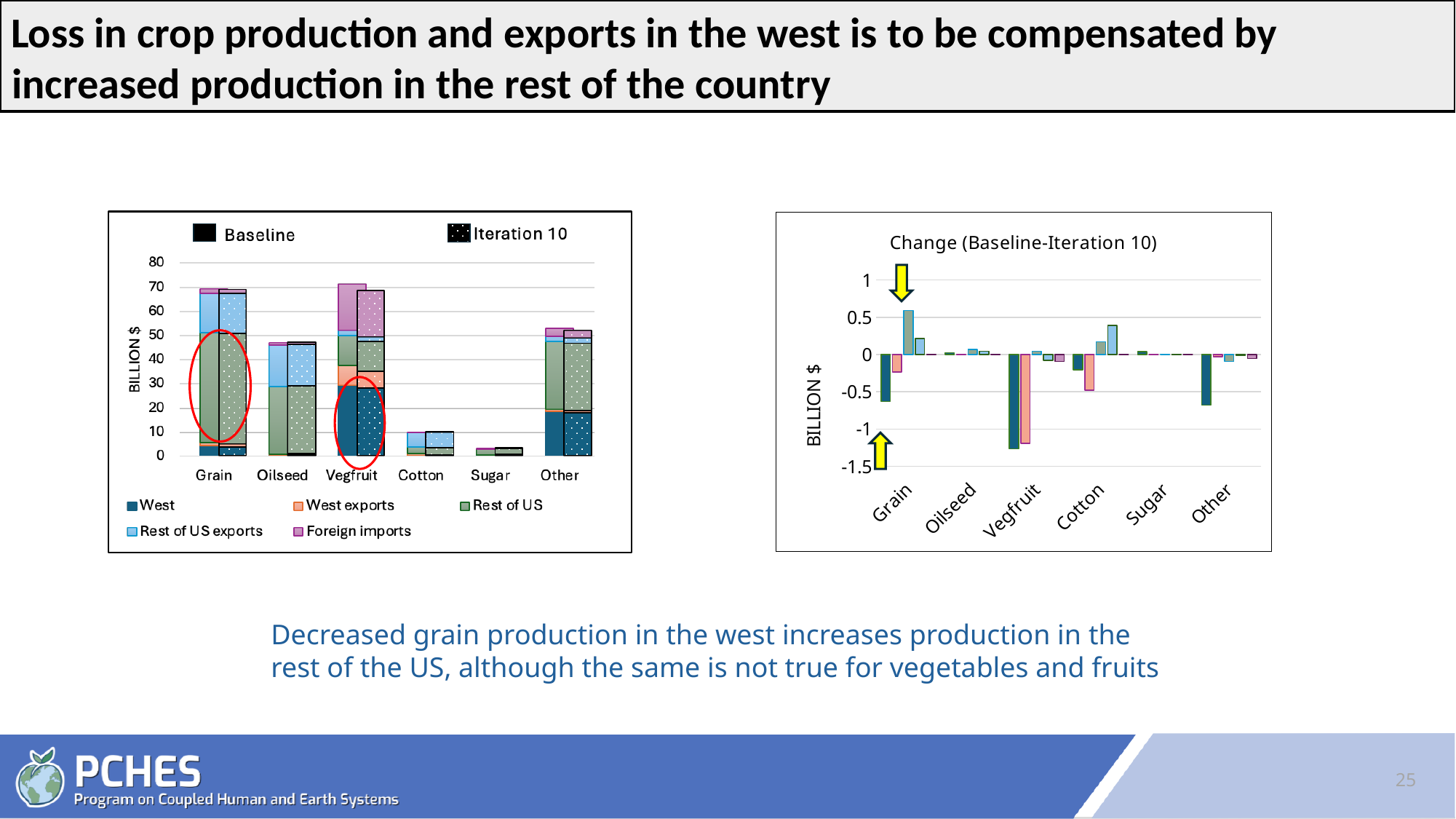
What kind of chart is the left chart on the slide? stacked bar chart What is the title of the right chart? Change (Baseline-Iteration 10) What is the y-axis label of the right chart? BILLION $ How many series does the colour legend of the left chart list? 5 In the left chart, which is larger: the Baseline total for Other or the Baseline total for Cotton? Other In the left chart, is the Baseline total for Oilseed greater or less than 40? greater In the right chart, which crop category has the highest positive bar? Grain How many crop categories are shown on the x axis of the left chart? 6 In the left chart, is the Baseline total for Cotton greater or less than 20? less In the left chart, which crop category has the lowest total bar? Sugar In the right chart, which crop category has the most negative bar? Vegfruit In the right chart, is the West value for Vegfruit greater or less than -1? less